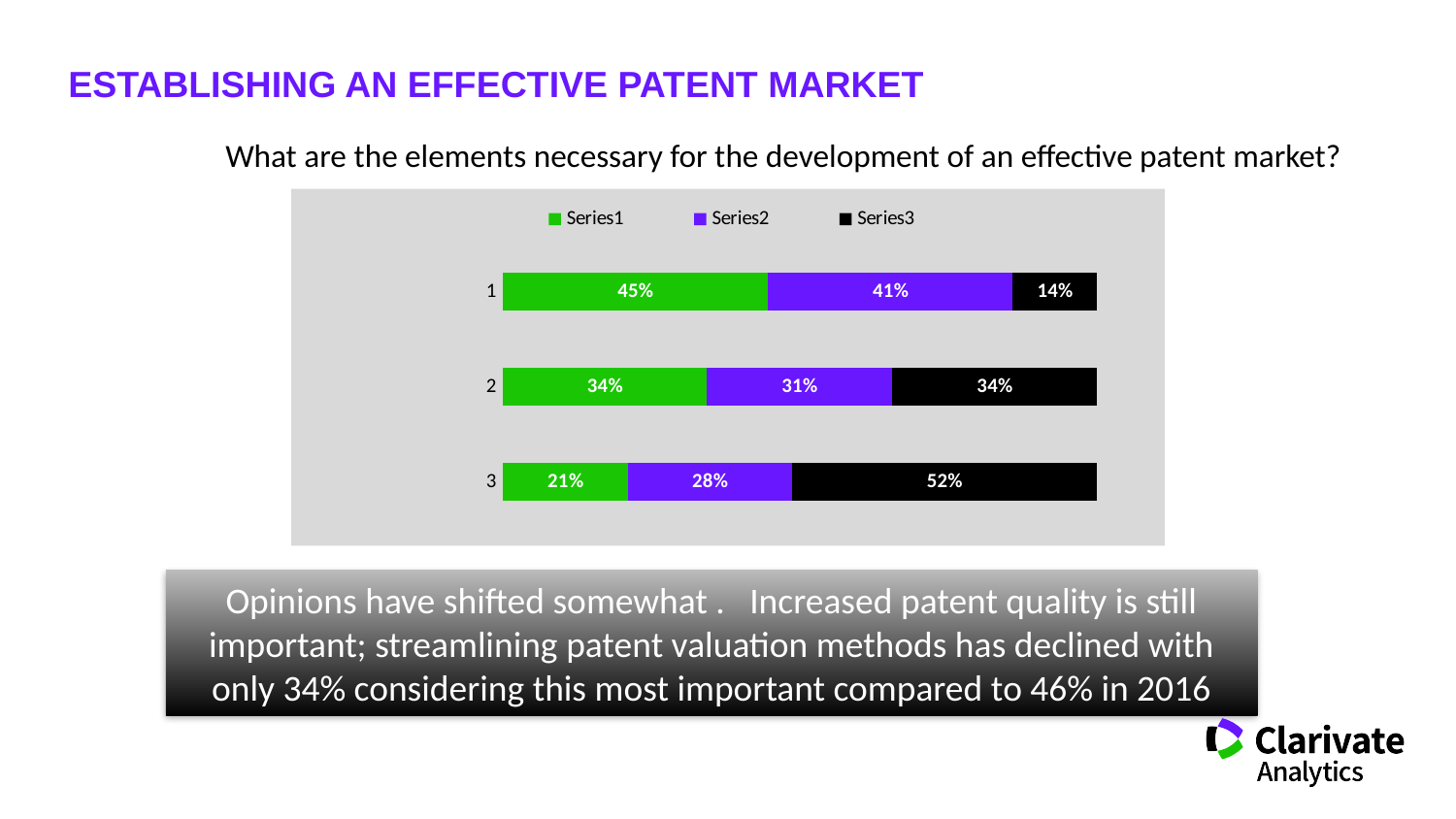
What colour represents Series3 in the chart? Black What is the Series3 value for category 3? 52% Which category has the lowest Series3 value? 1 Which is larger: the Series2 value for category 1 or the Series2 value for category 3? Series2 value for category 1 What is the Series3 value for category 1? 14% What is the Series2 value for category 2? 31% What is the difference between the Series1 value for category 1 and the Series1 value for category 3? 24% How many categories are shown on the chart? 3 How many series does the legend list? 3 What kind of chart is shown on the slide? Stacked bar chart What is the Series1 value for category 1? 45% Which category has the highest Series1 value? 1